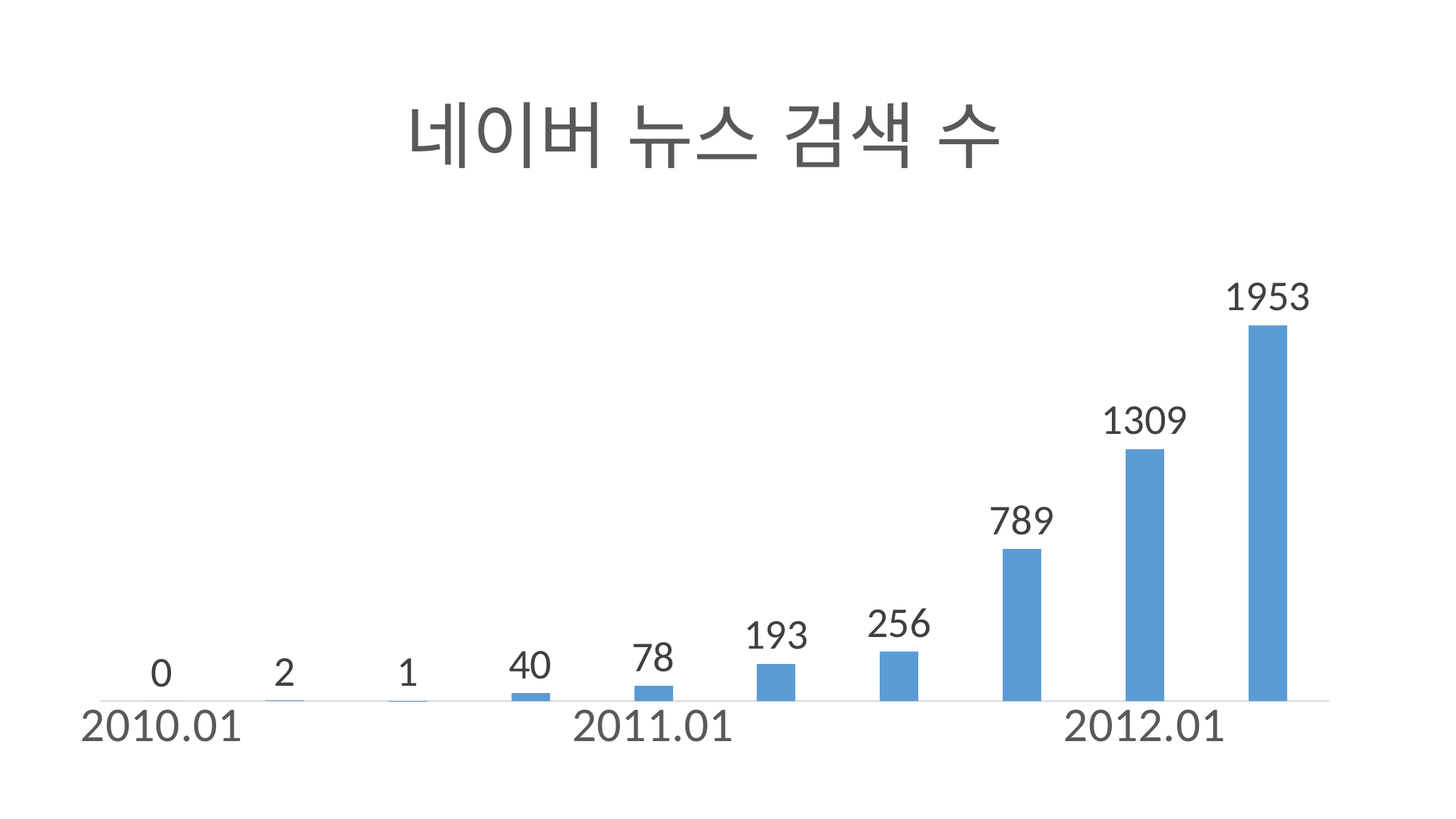
What is the difference between the bar labelled 2012.01 and the bar labelled 2011.01? 1231 What is the title of the chart? 네이버 뉴스 검색 수 What is the value of the bar labelled 2012.01? 1309 Which is larger, the value for 2011.01 or the value for 2012.01? 2012.01 Do the values generally rise or fall from left to right along the x axis? rise How many bars are plotted in the chart? 10 What kind of chart is shown on the slide? bar chart What is the difference between the rightmost bar (1953) and the bar labelled 2012.01? 644 What is the value of the tallest bar in the chart? 1953 What is the value of the bar labelled 2011.01? 78 What is the value of the bar labelled 2010.01? 0 What is the value of the lowest bar in the chart? 0